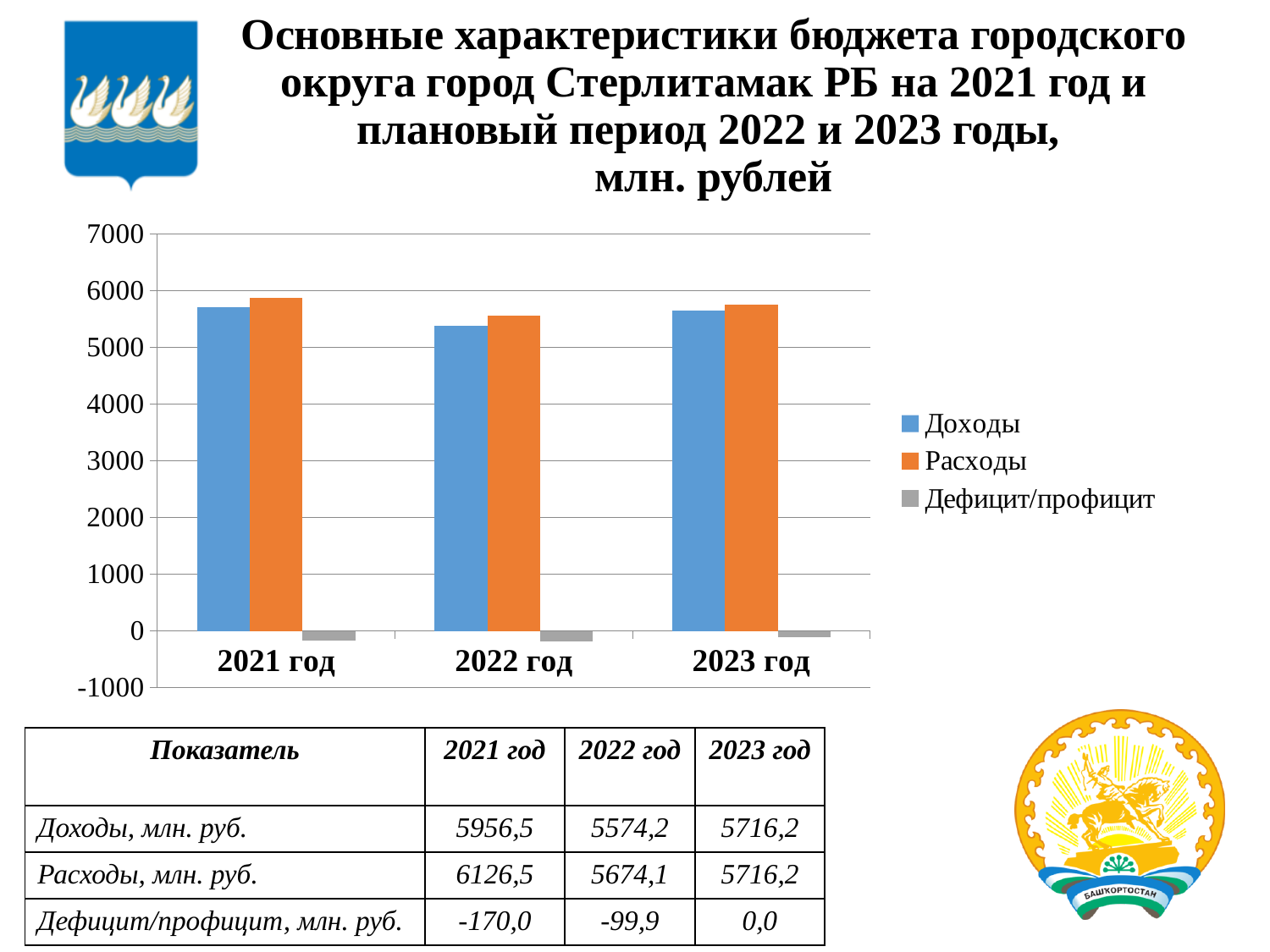
In which year is the Доходы bar the lowest? 2022 год In 2021 год, which bar is taller: Доходы or Расходы? Расходы Does the Доходы bar rise or fall from 2021 год to 2022 год? fall What kind of chart is shown on the slide? bar chart Is the Дефицит/профицит bar for 2021 год greater or less than 0? less Is the Доходы bar for 2022 год greater or less than 6000? less How many year categories are shown on the x axis of the chart? 3 According to the table below the chart, what is the value of Доходы for 2022 год? 5574,2 Which colour represents Расходы in the chart? orange Is the Доходы bar for 2021 год greater or less than 5000? greater How many series does the chart legend list? 3 What are the three series named in the chart legend? Доходы, Расходы, Дефицит/профицит